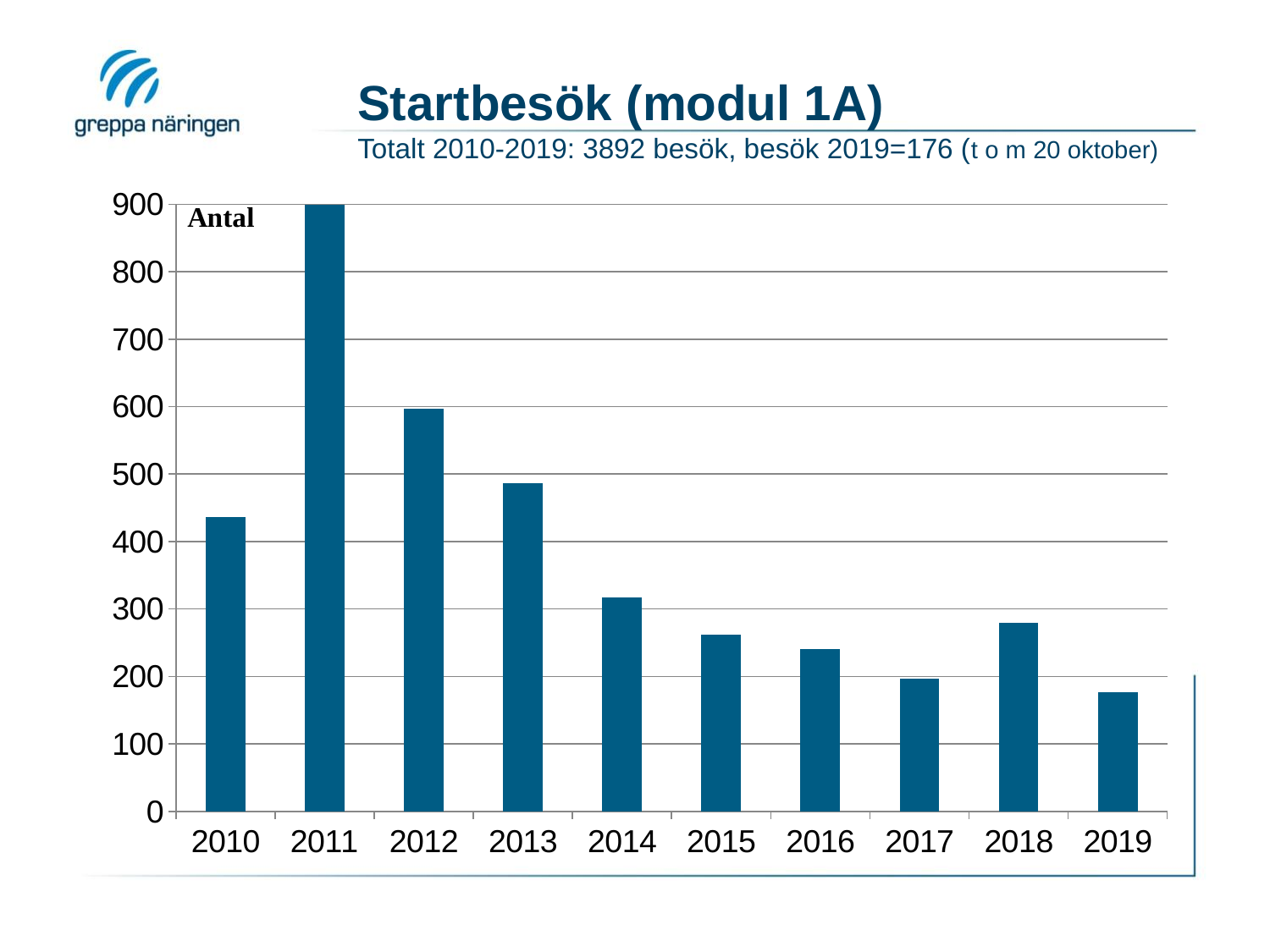
Is the value for 2010 greater or less than 400? greater Which year has the highest number of startbesök? 2011 Is the value for 2016 greater or less than 300? less How many startbesök were made in 2019 according to the slide? 176 What kind of chart is shown on the slide? bar chart Which year has the lowest number of startbesök? 2019 What label is shown at the top of the y axis of the chart? Antal Is the value for 2012 greater or less than 500? greater Do the values rise or fall from 2011 to 2017? fall How many years are shown on the x axis of the chart? 10 Which year has a higher value, 2012 or 2013? 2012